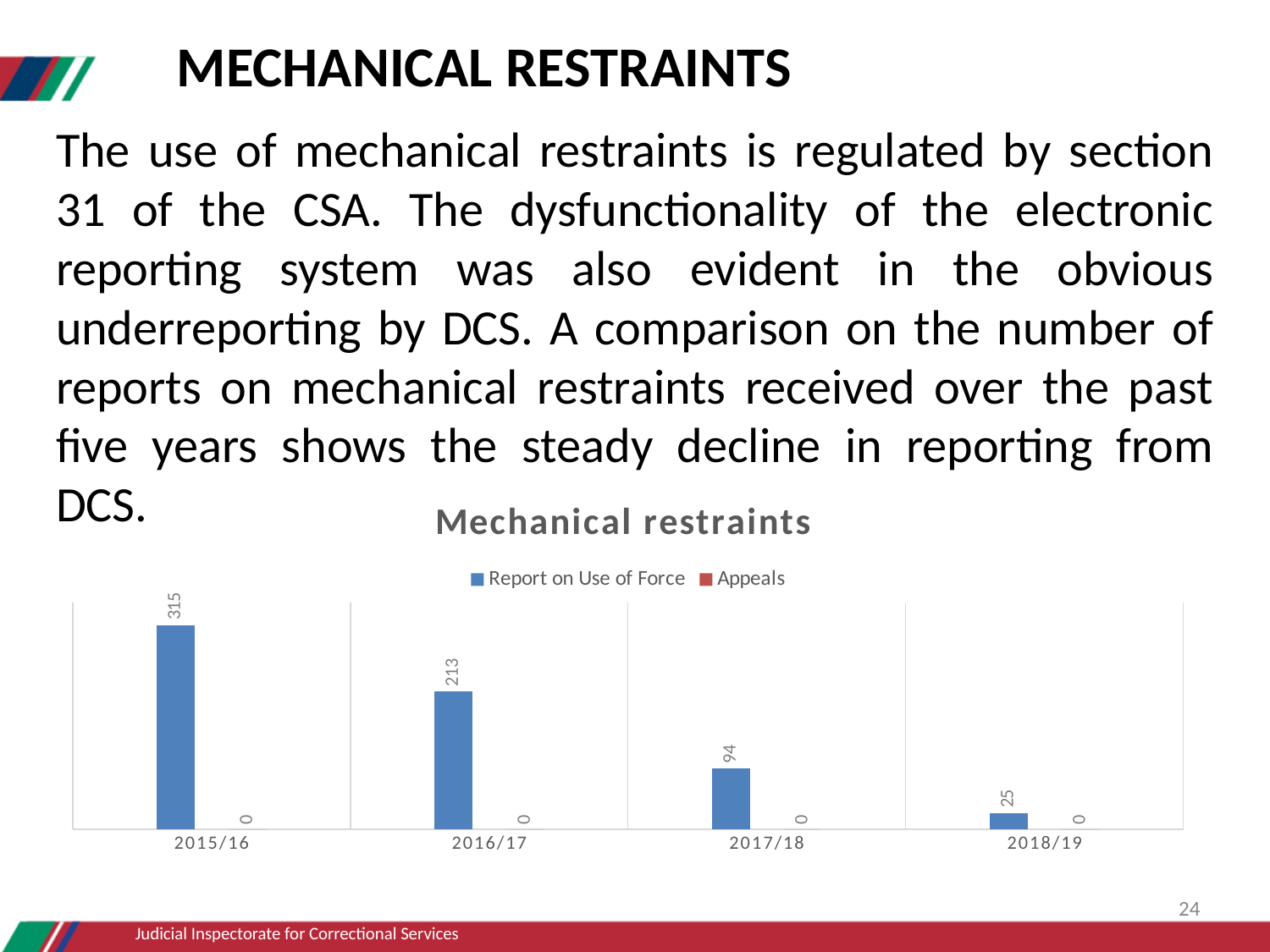
What is the difference between the Report on Use of Force values for 2015/16 and 2016/17? 102 What is the value for Report on Use of Force in 2017/18? 94 Which year has the lowest value for Report on Use of Force? 2018/19 What is the value for Report on Use of Force in 2018/19? 25 What is the value for Report on Use of Force in 2016/17? 213 Which year has the highest value for Report on Use of Force? 2015/16 How many series does the legend list? 2 What is the value for Report on Use of Force in 2015/16? 315 How many years are shown on the x axis? 4 Which is larger, the Report on Use of Force value for 2016/17 or for 2017/18? 2016/17 What kind of chart is shown? Bar chart What is the value for Appeals in 2017/18? 0